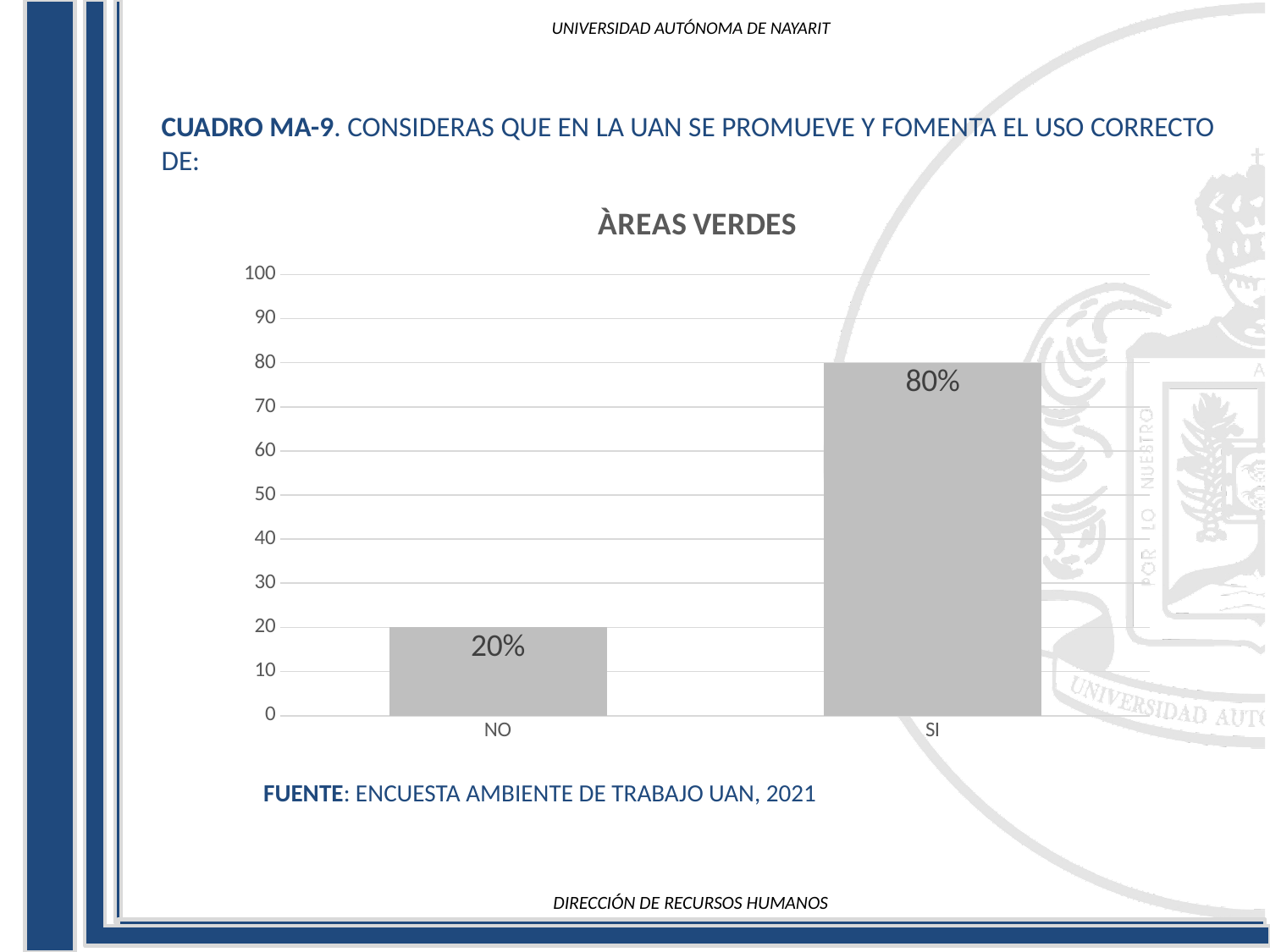
What is the title of the chart? ÀREAS VERDES What kind of chart is shown? bar chart Which category has the highest value? SI What is the difference between the values for SI and NO? 60% How many categories are shown on the x axis? 2 Is the value for NO greater or less than 30? less Which category has the lowest value? NO Which is larger, the value for NO or the value for SI? SI Is the value for SI greater or less than 50? greater What is the value for NO? 20% What is the maximum value shown on the y axis? 100 What is the value for SI? 80%